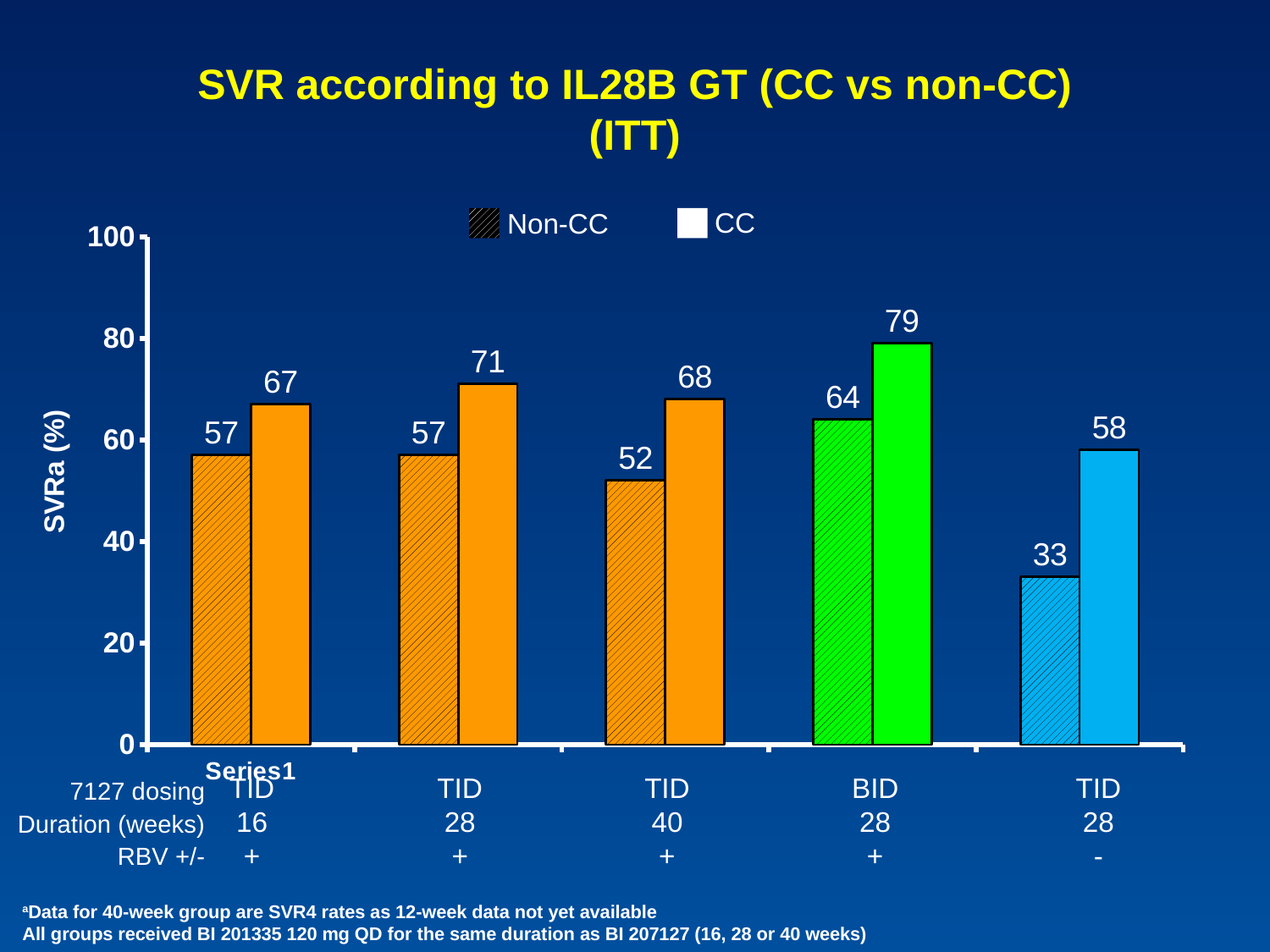
Which group has the highest CC value? BID 28 weeks (RBV +) What is the difference between the CC and Non-CC values for the TID 16-week group? 10 What is the Non-CC value for the TID 28-week group without RBV (RBV -)? 33 Which is larger, the CC value for the TID 28-week group with RBV or the CC value for the TID 40-week group? TID 28-week group with RBV (71) What kind of chart is shown on the slide? Bar chart How many series does the legend list? 2 What is the difference between the CC and Non-CC values for the TID 28-week group without RBV (RBV -)? 25 Which group has the lowest Non-CC value? TID 28 weeks (RBV -) How many dosing groups are shown on the x axis? 5 What is the Non-CC value for the TID 40-week group? 52 Is the Non-CC value for the BID 28-week group greater or less than 60? greater What is the CC value for the BID 28-week group? 79